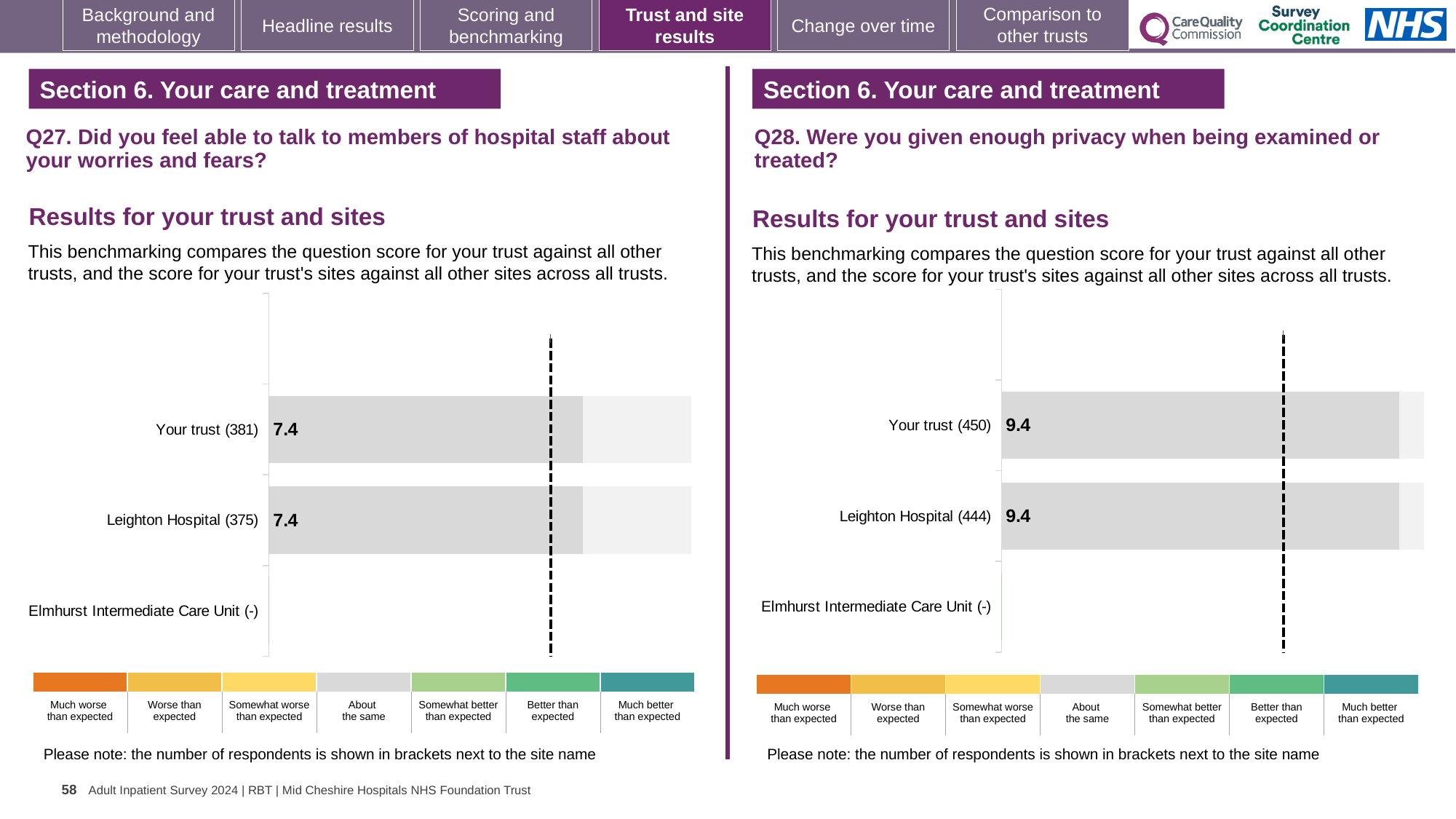
On the Q27 chart (left), what is the difference between the scores for Your trust and Leighton Hospital? 0 On the Q27 chart (left), what is the score for Your trust? 7.4 On the Q28 chart (right), what is the score for Leighton Hospital? 9.4 How many site/trust categories are listed on the Q27 chart (left)? 3 On the Q28 chart (right), what is the difference between the scores for Your trust and Leighton Hospital? 0 On the Q27 chart (left), how many respondents are shown in brackets for Your trust? 381 Is the score for Your trust on the Q28 chart (right) larger or smaller than the score for Your trust on the Q27 chart (left)? Larger On the Q28 chart (right), how many respondents are shown in brackets for Leighton Hospital? 444 On the Q27 chart (left), what is the score for Leighton Hospital? 7.4 How many site/trust categories are listed on the Q28 chart (right)? 3 What kind of chart is used for the Q27 results (left)? Bar chart On the Q28 chart (right), what is the score for Your trust? 9.4